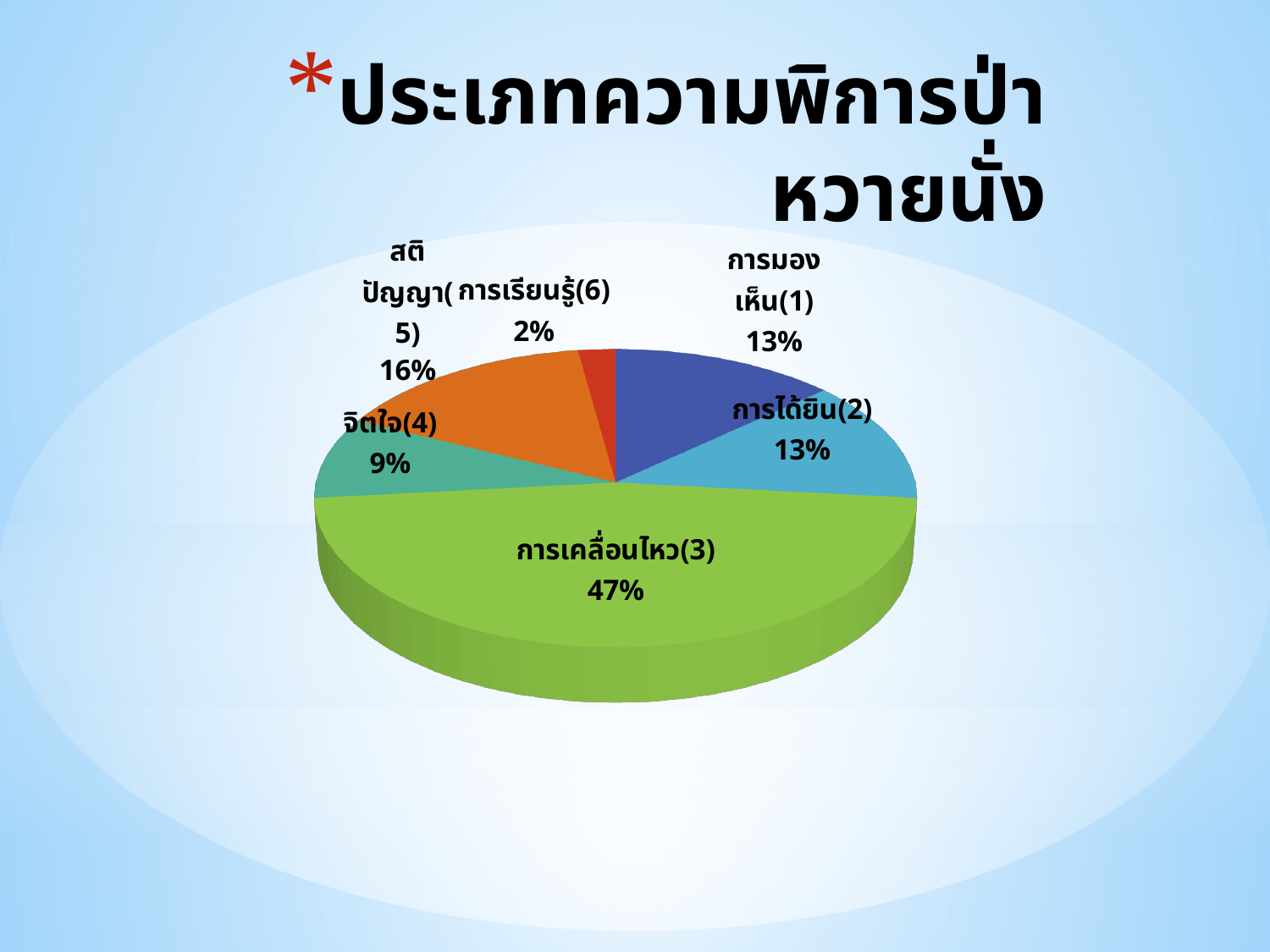
Which category has the largest slice of the pie? การเคลื่อนไหว(3) What is the difference between the shares of การเคลื่อนไหว(3) and สติปัญญา(5)? 31% What colour is the slice for การเคลื่อนไหว(3)? Green What share of the pie does การเคลื่อนไหว(3) have? 47% What is the value shown for สติปัญญา(5)? 16% How many categories are shown in the pie chart? 6 Which is larger, the share for สติปัญญา(5) or the share for จิตใจ(4)? สติปัญญา(5) What is the value shown for การเรียนรู้(6)? 2% What is the value shown for การมองเห็น(1)? 13% Which category has the smallest slice of the pie? การเรียนรู้(6) What is the value shown for จิตใจ(4)? 9% What kind of chart is shown on the slide? Pie chart